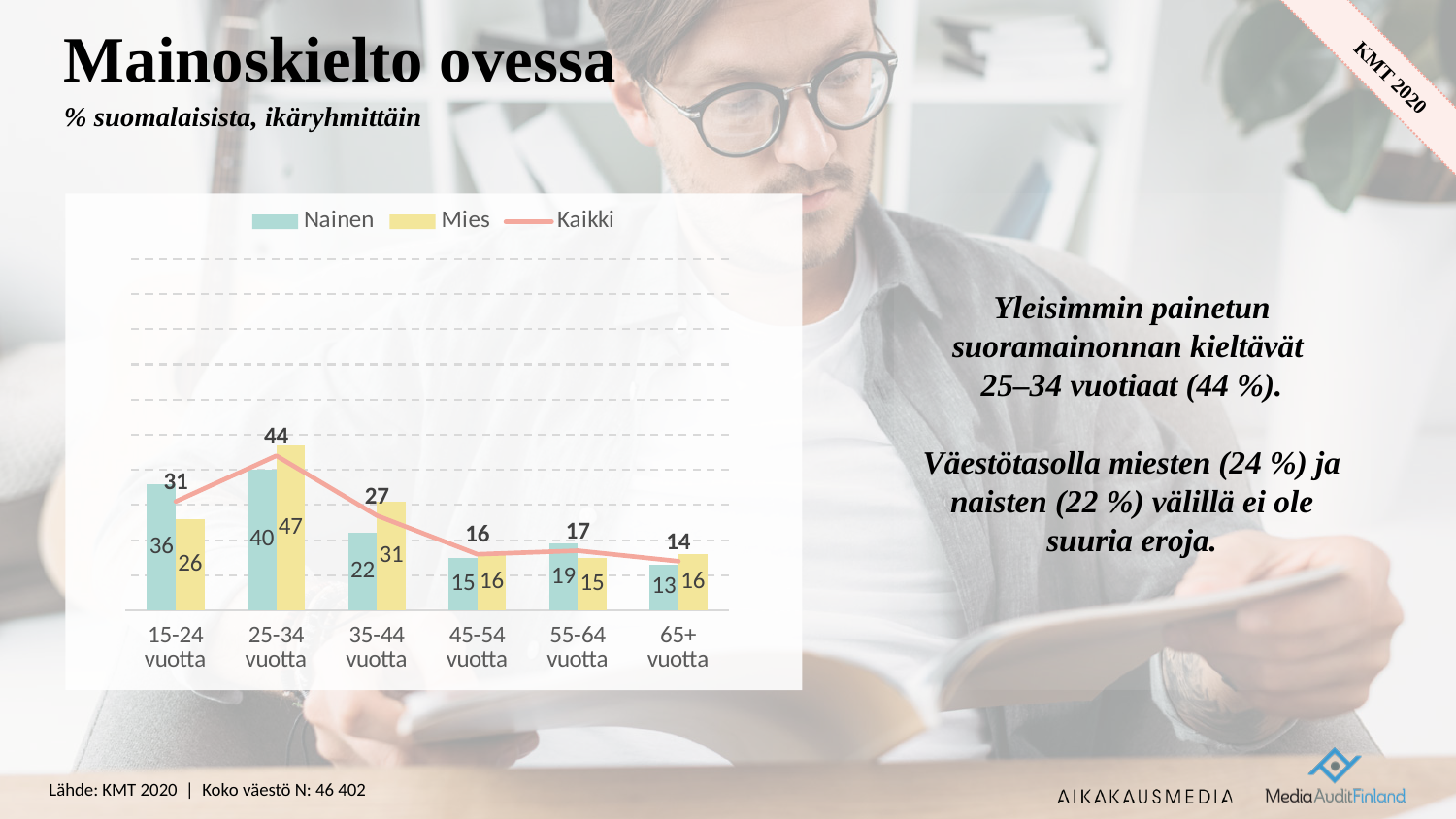
What is the value for Nainen in the 25-34 vuotta age group? 40 How many age groups are shown on the x axis? 6 Which age group has the lowest Nainen value? 65+ vuotta What is the Kaikki value for the 15-24 vuotta age group? 31 Which age group has the highest Kaikki value? 25-34 vuotta Does the Kaikki line rise or fall from 25-34 vuotta to 65+ vuotta? Fall What kind of chart is this? Bar chart with a line What is the value for Mies in the 35-44 vuotta age group? 31 How many series does the legend list? 3 In the 55-64 vuotta age group, which is larger, Nainen or Mies? Nainen What is the difference between the Mies and Nainen values in the 15-24 vuotta age group? 10 What is the subtitle of the chart? % suomalaisista, ikäryhmittäin